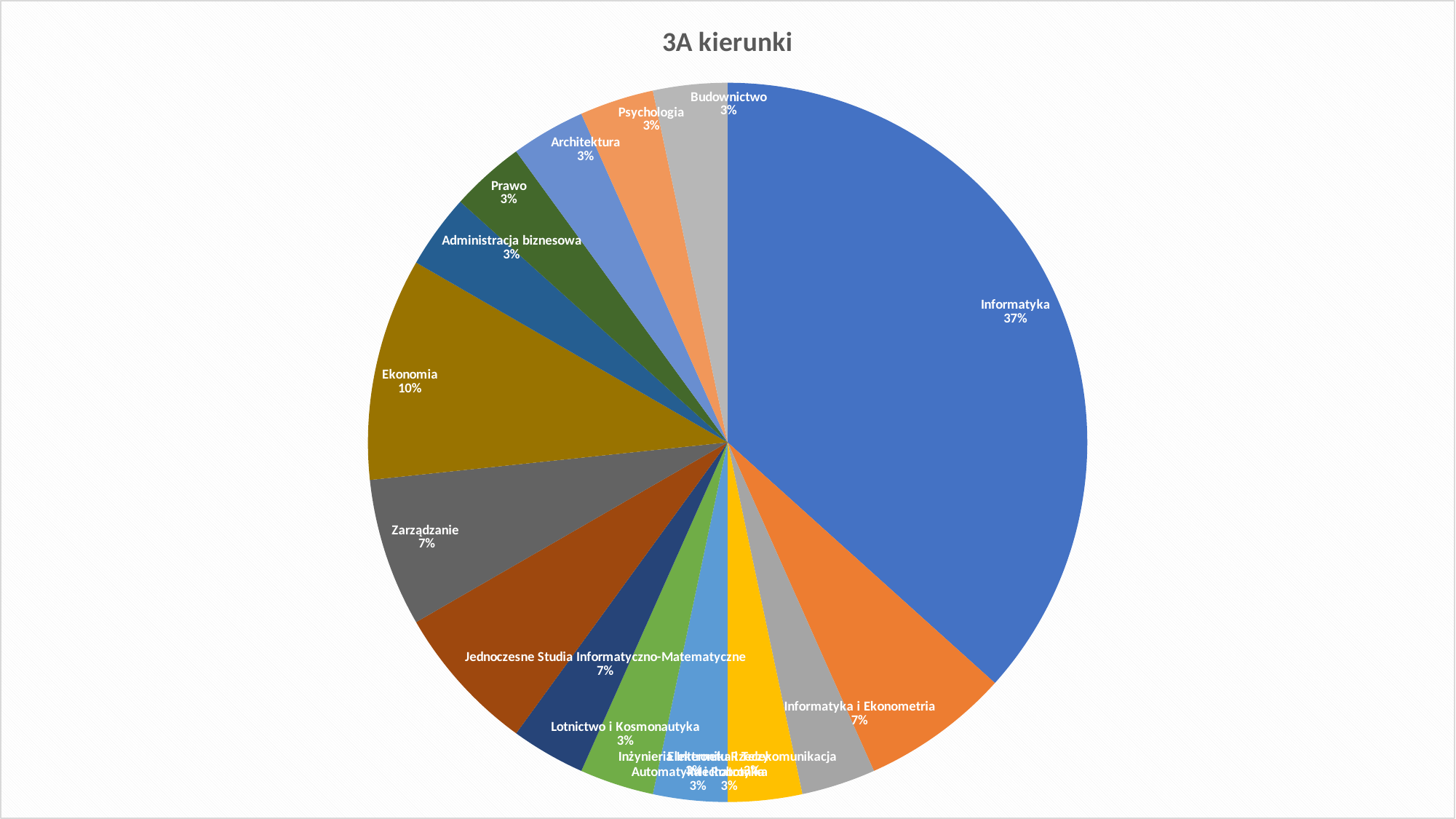
What is the value shown for Prawo? 3% What is the value shown for Zarządzanie? 7% Which category has the largest share of the pie? Informatyka What is the title of the chart? 3A kierunki What is the value shown for Jednoczesne Studia Informatyczno-Matematyczne? 7% What share of the pie does Informatyka have? 37% What is the value shown for Informatyka i Ekonometria? 7% Which has a larger share, Informatyka i Ekonometria or Budownictwo? Informatyka i Ekonometria What kind of chart is shown on the slide? pie chart What is the difference between the shares of Informatyka and Ekonomia? 27% What is the value shown for Ekonomia? 10% Which has a larger share, Ekonomia or Zarządzanie? Ekonomia